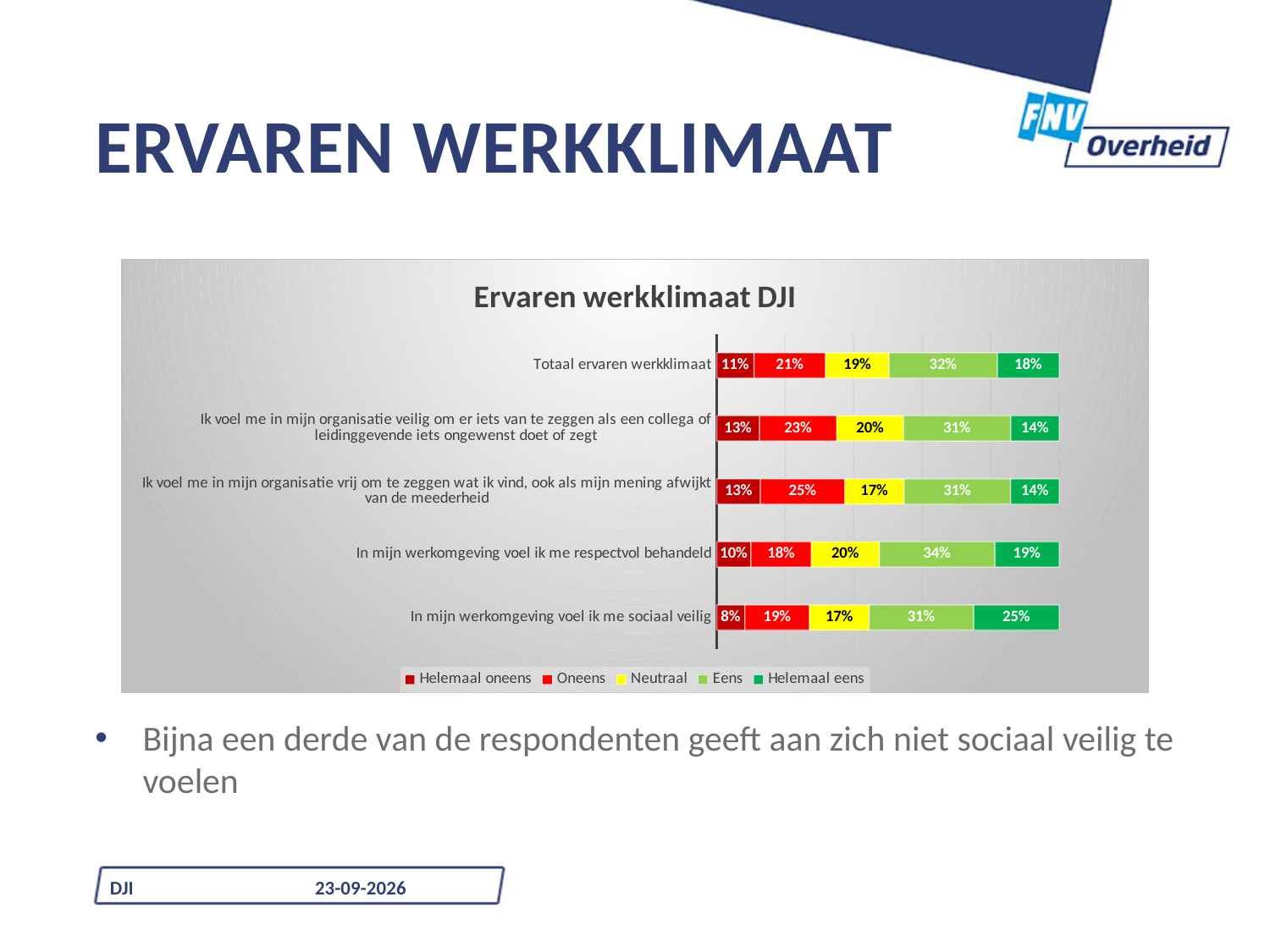
What is the difference between the 'Eens' value for 'In mijn werkomgeving voel ik me respectvol behandeld' and the 'Eens' value for 'Totaal ervaren werkklimaat'? 2% What is the 'Helemaal eens' value for 'In mijn werkomgeving voel ik me sociaal veilig'? 25% How many series does the legend list? 5 What is the 'Eens' value for 'Totaal ervaren werkklimaat'? 32% Which category has the lowest 'Helemaal oneens' value? In mijn werkomgeving voel ik me sociaal veilig How many categories are shown in the chart? 5 Which category has the highest 'Helemaal eens' value? In mijn werkomgeving voel ik me sociaal veilig Which is larger: the 'Oneens' value for 'Ik voel me in mijn organisatie veilig om er iets van te zeggen als een collega of leidinggevende iets ongewenst doet of zegt' or the 'Oneens' value for 'In mijn werkomgeving voel ik me sociaal veilig'? Ik voel me in mijn organisatie veilig om er iets van te zeggen als een collega of leidinggevende iets ongewenst doet of zegt What kind of chart is shown on the slide? Stacked bar chart What is the title of the chart? Ervaren werkklimaat DJI What is the 'Neutraal' value for 'In mijn werkomgeving voel ik me respectvol behandeld'? 20% What is the 'Oneens' value for 'Ik voel me in mijn organisatie vrij om te zeggen wat ik vind, ook als mijn mening afwijkt van de meederheid'? 25%